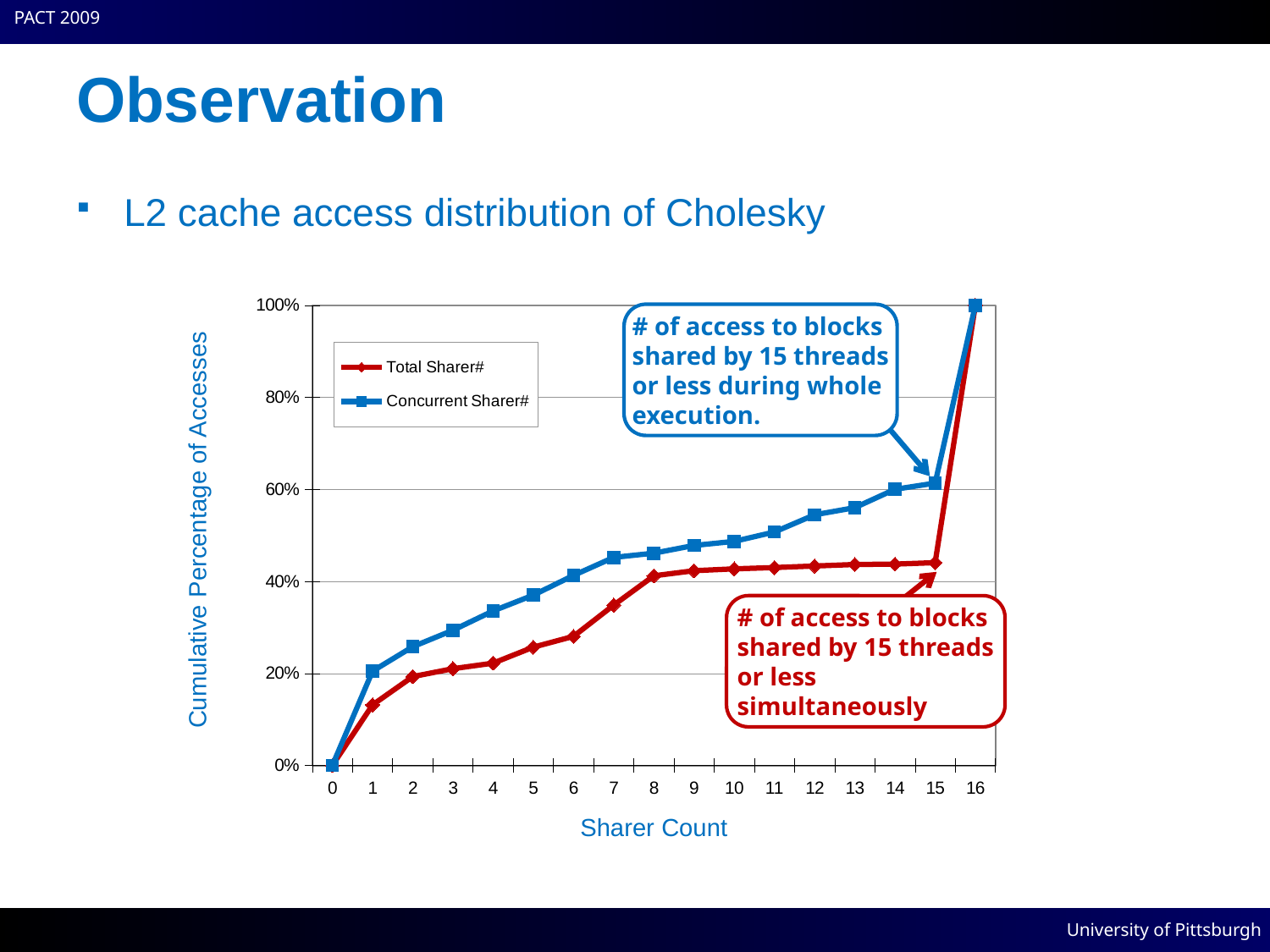
What is the title of the x axis of the chart? Sharer Count What is the value of Concurrent Sharer# at sharer count 16? 100% Is the value of Concurrent Sharer# at sharer count 8 greater or less than 40%? greater What kind of chart is shown on the slide? line chart What are the two series named in the chart's legend? Total Sharer# and Concurrent Sharer# At sharer count 15, which series has the higher value, Total Sharer# or Concurrent Sharer#? Concurrent Sharer# Is the value of Total Sharer# at sharer count 1 greater or less than 20%? less How many sharer count values are plotted along the x axis? 17 Is the value of Total Sharer# at sharer count 15 greater or less than 60%? less Do the values of Concurrent Sharer# rise or fall as sharer count increases from 0 to 16? rise What is the value of Total Sharer# at sharer count 0? 0% How many series does the chart's legend list? 2